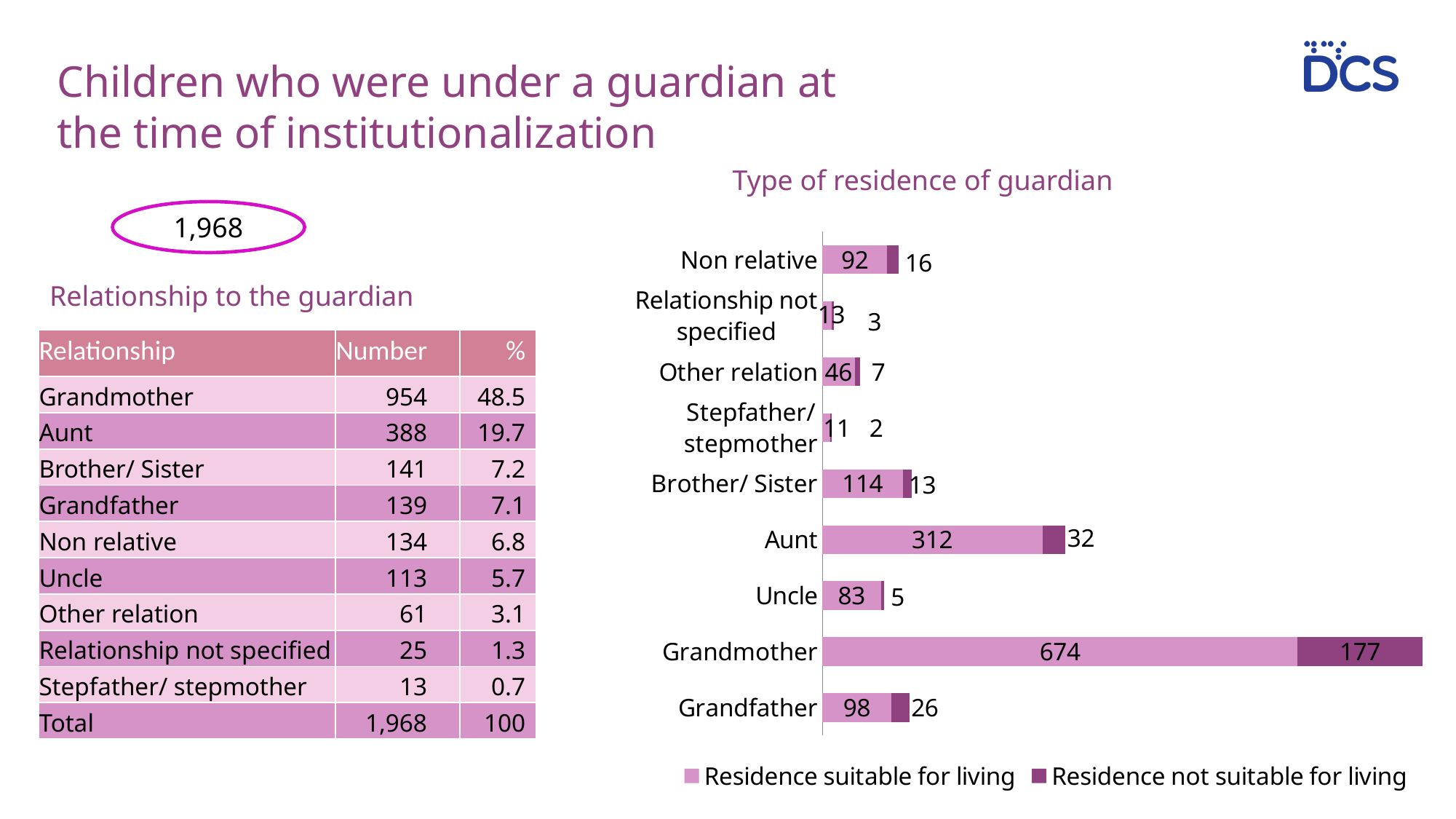
In the 'Type of residence of guardian' chart, what is the total of the stacked bar for Grandmother? 851 How many categories are shown in the 'Type of residence of guardian' chart? 9 In the 'Type of residence of guardian' chart, which category has the highest value for 'Residence suitable for living'? Grandmother In the 'Type of residence of guardian' chart, what is the value of 'Residence not suitable for living' for Aunt? 32 In the 'Type of residence of guardian' chart, what is the value of 'Residence suitable for living' for Grandmother? 674 In the 'Type of residence of guardian' chart, which category has the lowest value for 'Residence not suitable for living'? Stepfather/ stepmother In the 'Type of residence of guardian' chart, what is the difference between the 'Residence suitable for living' values for Aunt and Brother/ Sister? 198 In the 'Type of residence of guardian' chart, what is the value of 'Residence suitable for living' for Uncle? 83 How many series does the legend of the 'Type of residence of guardian' chart list? 2 What kind of chart is 'Type of residence of guardian'? Stacked bar chart In the 'Type of residence of guardian' chart, what is the value of 'Residence not suitable for living' for Grandfather? 26 In the 'Type of residence of guardian' chart, which is larger for 'Residence suitable for living': Non relative or Grandfather? Grandfather